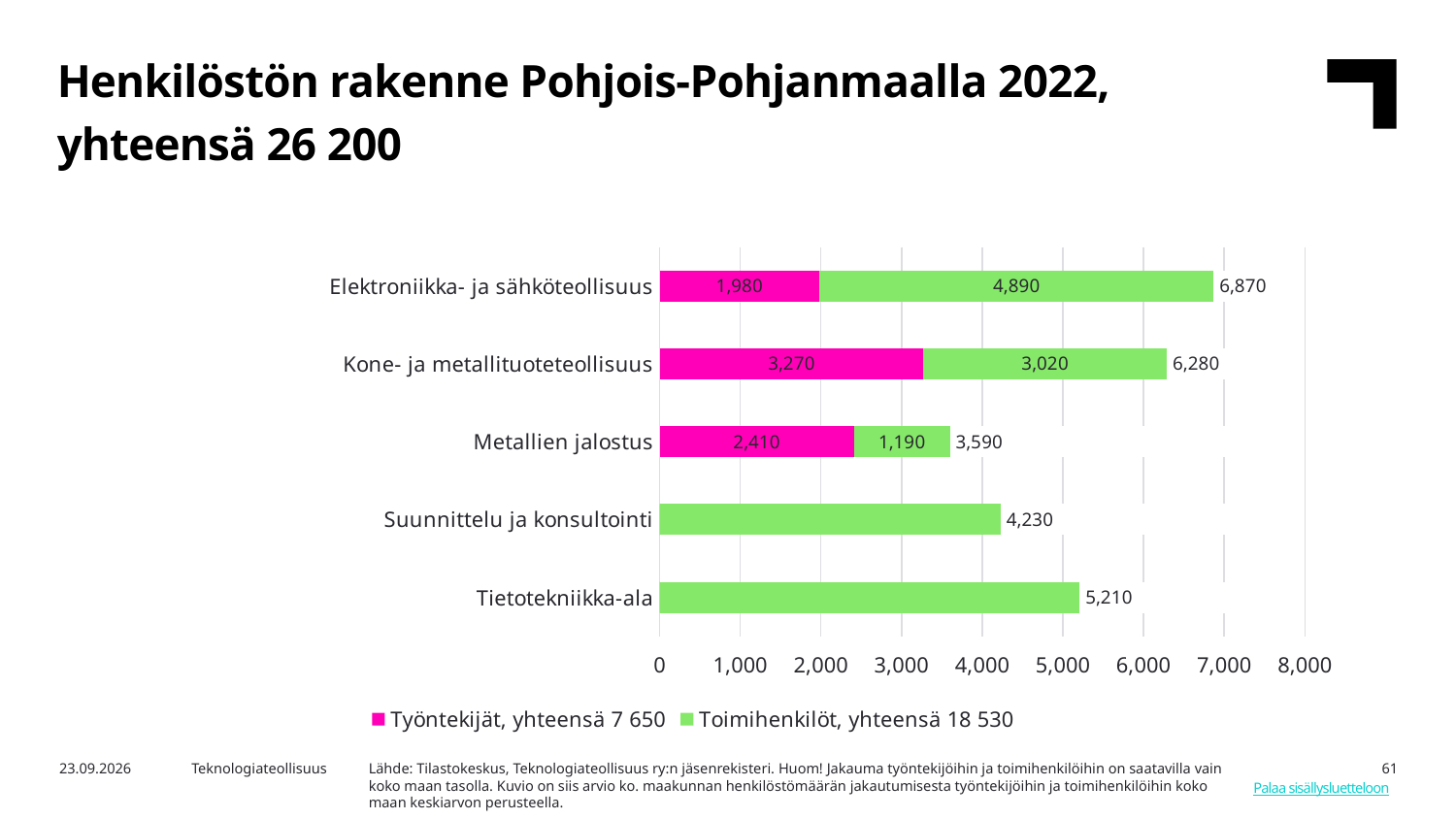
How many categories are shown on the chart? 5 Which category has the highest total? Elektroniikka- ja sähköteollisuus Which is larger: the Työntekijät value for Metallien jalostus or the Työntekijät value for Elektroniikka- ja sähköteollisuus? Metallien jalostus How many series does the legend list? 2 What is the difference between the totals of Tietotekniikka-ala and Suunnittelu ja konsultointi? 980 What is the Toimihenkilöt value for Elektroniikka- ja sähköteollisuus? 4,890 Which category has the lowest total? Metallien jalostus What is the Työntekijät value for Kone- ja metallituoteteollisuus? 3,270 Is the total for Suunnittelu ja konsultointi greater or less than 4,000? greater What kind of chart is shown on the slide? Stacked bar chart What is the total for the Metallien jalostus bar? 3,590 What is the title of the slide? Henkilöstön rakenne Pohjois-Pohjanmaalla 2022, yhteensä 26 200